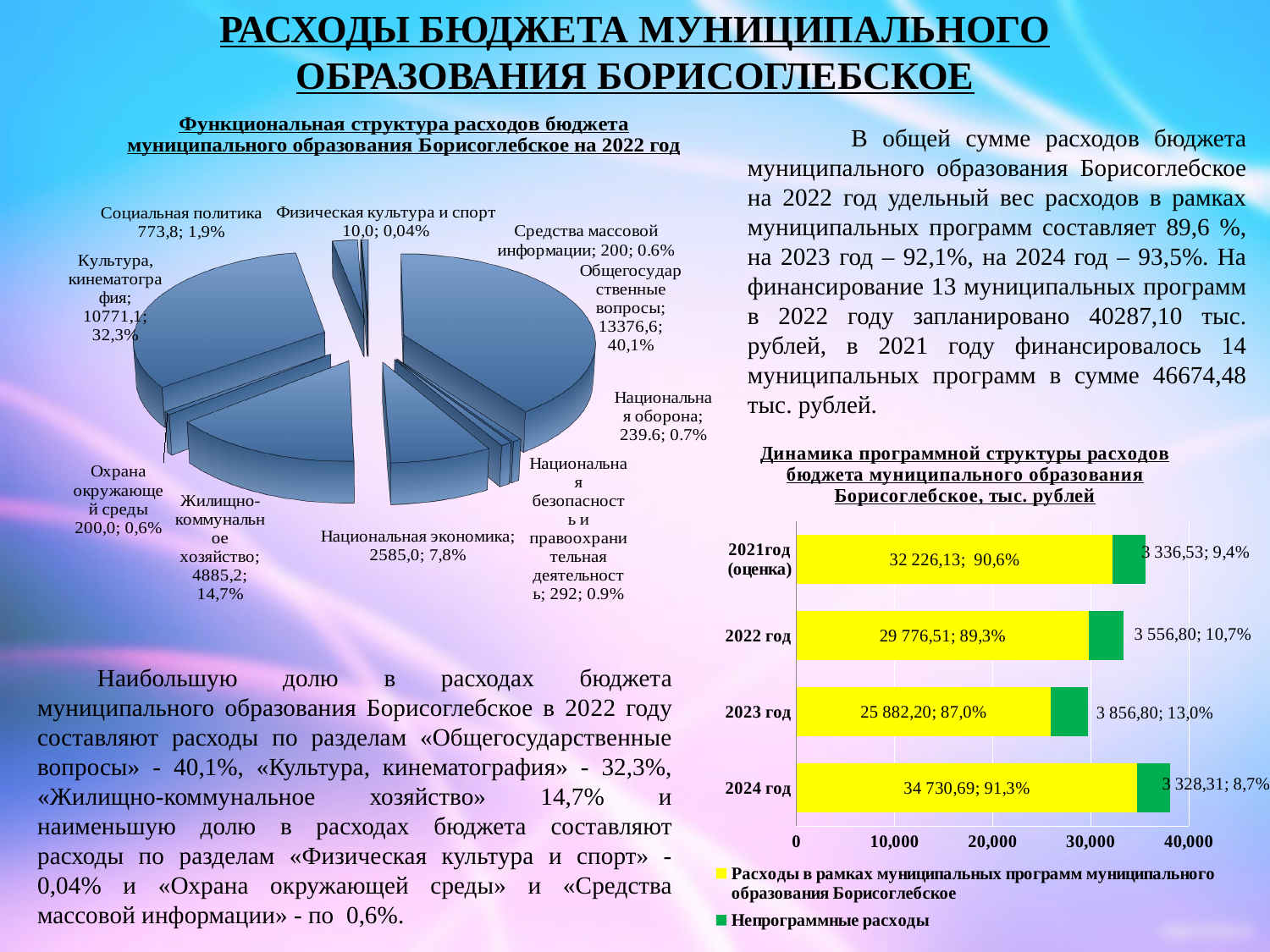
In the bar chart on the right, what is the value of 'Непрограммные расходы' for 2023 год? 3 856,80 In the bar chart on the right, which year has the highest value for 'Непрограммные расходы'? 2023 год In the pie chart on the left, what is the difference in share between 'Общегосударственные вопросы' and 'Культура, кинематография'? 7,8% In the bar chart 'Динамика программной структуры расходов бюджета муниципального образования Борисоглебское, тыс. рублей', what is the value of 'Расходы в рамках муниципальных программ' for 2024 год? 34 730,69 In the bar chart on the right, how many series does the legend list? 2 In the pie chart 'Функциональная структура расходов бюджета муниципального образования Борисоглебское на 2022 год', what share is shown for 'Общегосударственные вопросы'? 40,1% In the pie chart on the left, how many categories are shown? 10 What type of chart is the chart on the right of the slide? Stacked bar chart In the pie chart on the left, which is larger: 'Культура, кинематография' or 'Национальная экономика'? Культура, кинематография In the pie chart on the left, which category has the smallest share? Физическая культура и спорт In the pie chart on the left, what value is shown for 'Жилищно-коммунальное хозяйство'? 4885,2; 14,7% In the pie chart on the left, which category has the largest share? Общегосударственные вопросы